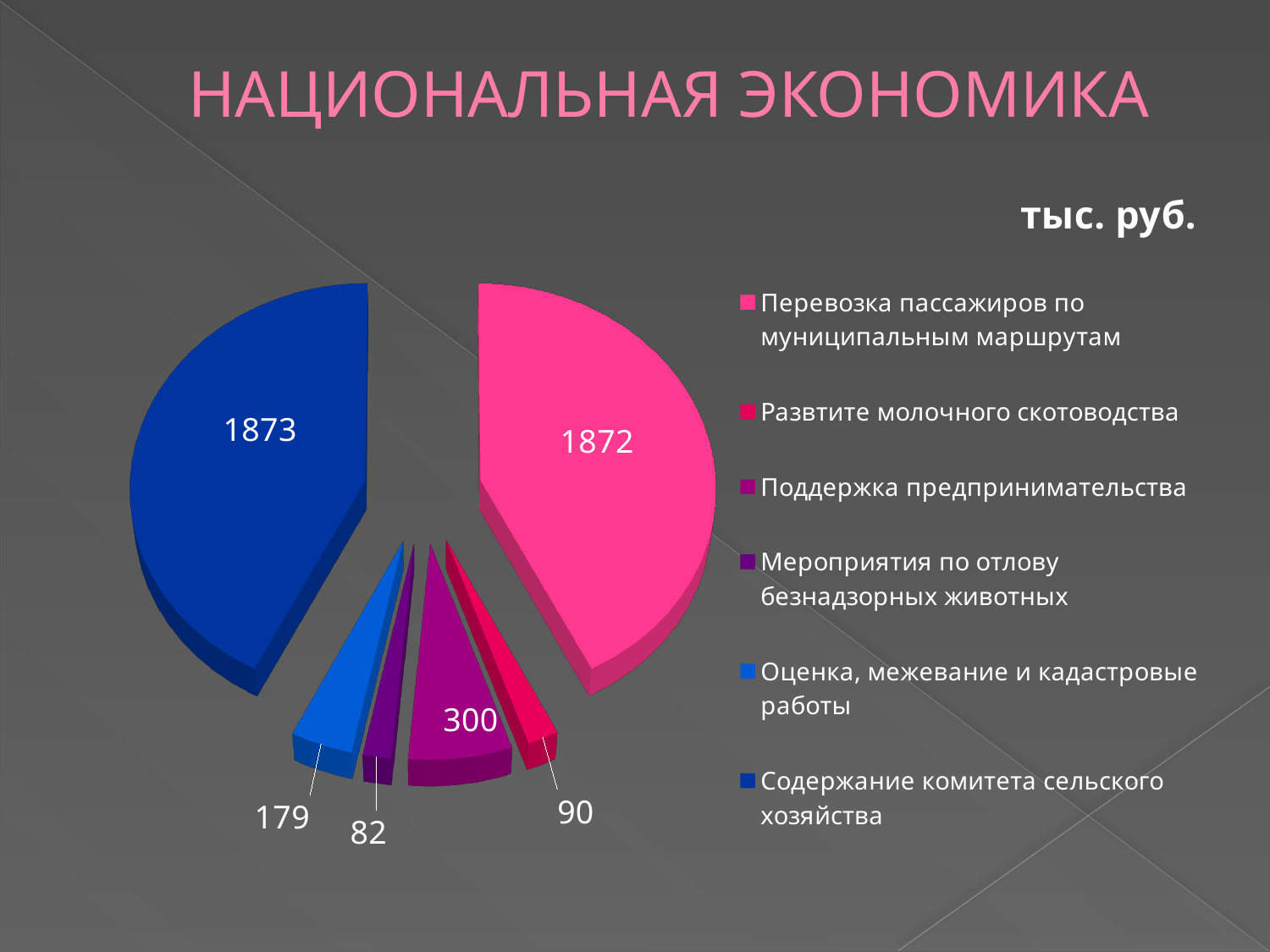
In what units are the values on the chart given? тыс. руб. Which is larger: the value for Оценка, межевание и кадастровые работы or the value for Мероприятия по отлову безнадзорных животных? Оценка, межевание и кадастровые работы What is the value for Содержание комитета сельского хозяйства? 1873 What is the value for Оценка, межевание и кадастровые работы? 179 What is the value for Развтите молочного скотоводства? 90 Which category has the smallest value? Мероприятия по отлову безнадзорных животных What is the difference between the values for Поддержка предпринимательства and Развтите молочного скотоводства? 210 What kind of chart is shown on the slide? pie chart What is the value for Поддержка предпринимательства? 300 What is the value for Перевозка пассажиров по муниципальным маршрутам? 1872 Which category has the largest value? Содержание комитета сельского хозяйства How many slices does the pie chart have? 6